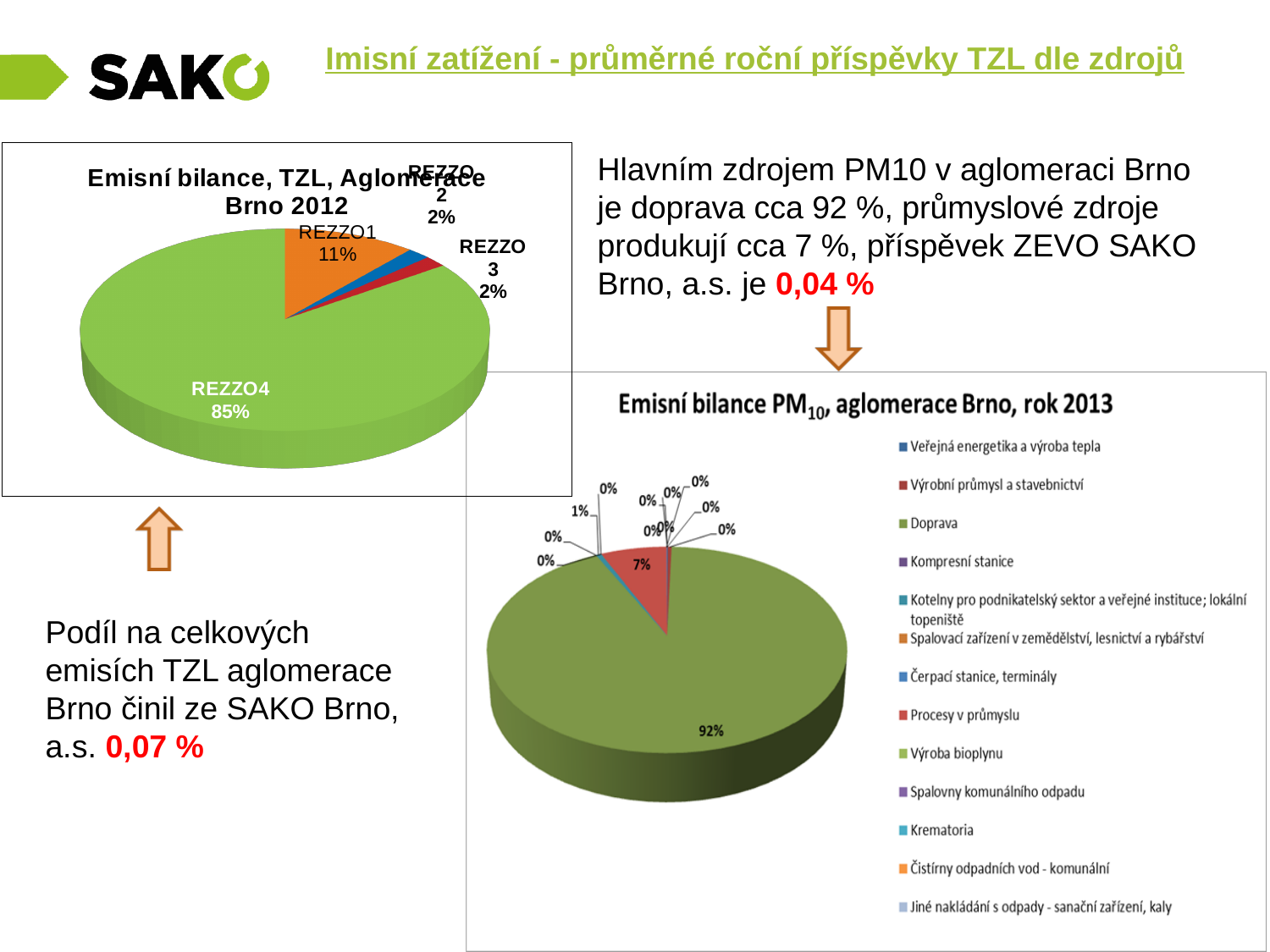
In the chart titled "Emisní bilance, TZL, Aglomerace Brno 2012", how many categories are shown? 4 What kind of chart is the one titled "Emisní bilance PM10, aglomerace Brno, rok 2013"? Pie chart In the chart titled "Emisní bilance, TZL, Aglomerace Brno 2012", what share does REZZO2 have? 2% In the chart titled "Emisní bilance, TZL, Aglomerace Brno 2012", what share does REZZO4 have? 85% In the chart titled "Emisní bilance, TZL, Aglomerace Brno 2012", which category has the largest slice? REZZO4 In the chart titled "Emisní bilance, TZL, Aglomerace Brno 2012", what is the difference in percentage points between REZZO4 and REZZO1? 74 In the chart titled "Emisní bilance PM10, aglomerace Brno, rok 2013", what share does the red slice (Výrobní průmysl a stavebnictví) have? 7% In the chart titled "Emisní bilance PM10, aglomerace Brno, rok 2013", which category has the largest slice? Doprava In the chart titled "Emisní bilance PM10, aglomerace Brno, rok 2013", how many entries does the legend list? 13 What kind of chart is the one titled "Emisní bilance, TZL, Aglomerace Brno 2012"? Pie chart